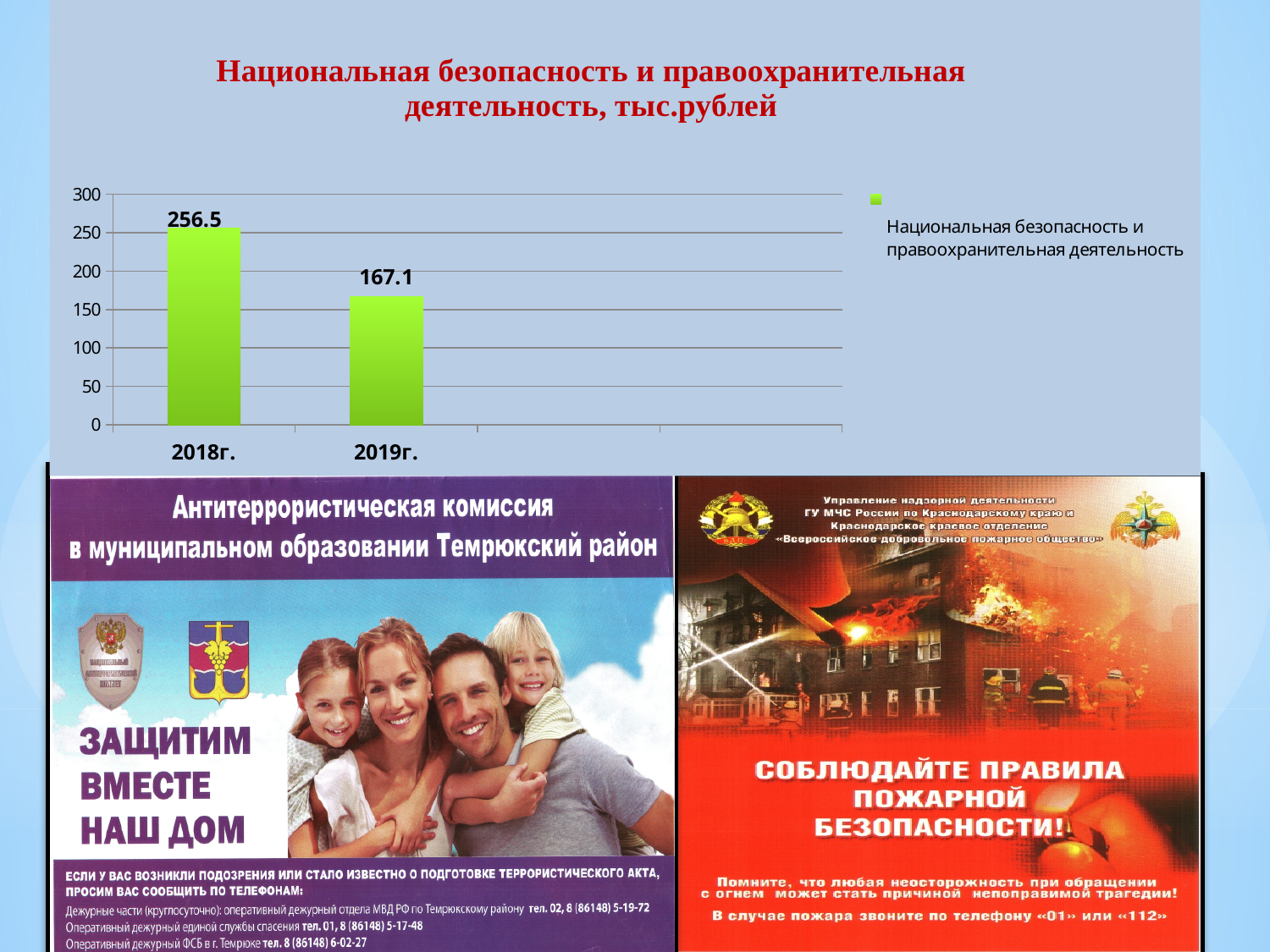
What is the value for 2018г.? 256.5 Is the value for 2019г. greater or less than 200? less What kind of chart is shown on the slide? bar chart Which is larger, the value for 2018г. or the value for 2019г.? 2018г. Is the value for 2018г. greater or less than 250? greater What is the difference between the values for 2018г. and 2019г.? 89.4 Do the values rise or fall from 2018г. to 2019г.? fall Which year has the highest value? 2018г. What is the value for 2019г.? 167.1 How many categories are shown on the x axis? 2 How many series does the legend list? 1 Which year has the lowest value? 2019г.